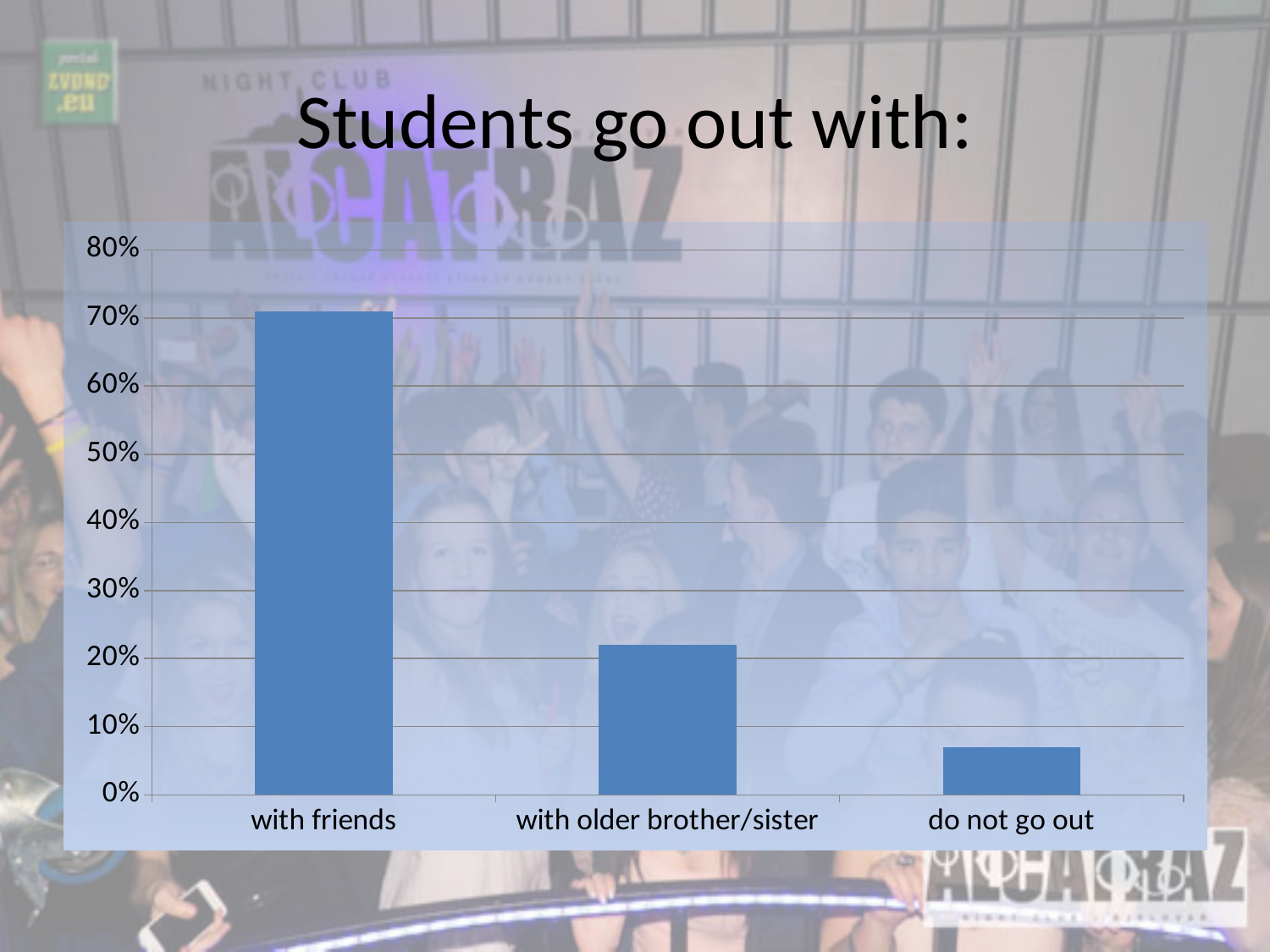
Which category has the highest value? with friends Is the value for 'with friends' greater or less than 60%? greater How many categories are shown on the x axis? 3 Which is larger, the value for 'with friends' or the value for 'with older brother/sister'? with friends Do the values rise or fall from left to right along the x axis? fall What is the title of the chart? Students go out with: Which category has the lowest value? do not go out Is the value for 'with older brother/sister' greater or less than 10%? greater What is the highest value shown on the y axis? 80% Is the value for 'do not go out' greater or less than 10%? less What kind of chart is shown on the slide? bar chart